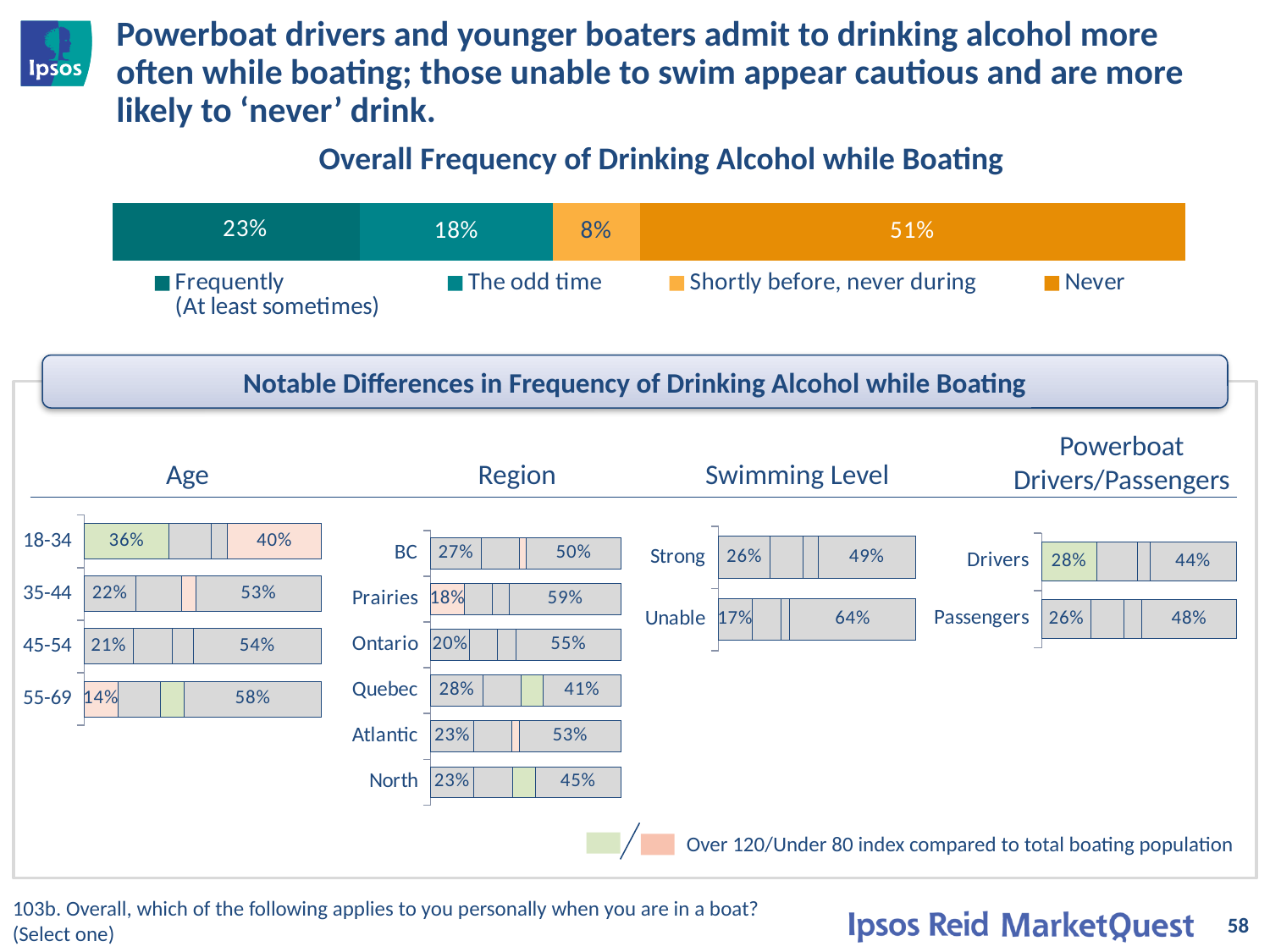
In the Swimming Level chart, what is the 'Never' percentage for those unable to swim? 64% In the 'Overall Frequency of Drinking Alcohol while Boating' chart, what percentage of boaters drink 'Frequently (At least sometimes)'? 23% In the Age chart, which age group has the highest 'Never' percentage? 55-69 What kind of chart is the 'Overall Frequency of Drinking Alcohol while Boating' chart? Stacked bar chart In the 'Overall Frequency of Drinking Alcohol while Boating' chart, what percentage of boaters answered 'Never'? 51% In the Region chart, which region has the highest 'Never' percentage? Prairies In the Age chart, what percentage of 18-34 year olds drink frequently while boating? 36% How many series does the legend of the 'Overall Frequency of Drinking Alcohol while Boating' chart list? 4 In the 'Overall Frequency of Drinking Alcohol while Boating' chart, what percentage answered 'Shortly before, never during'? 8% In the Region chart, what is the 'Never' percentage for Quebec? 41% In the Powerboat Drivers/Passengers chart, which group has the larger frequent-drinking percentage, Drivers or Passengers? Drivers In the 'Overall Frequency of Drinking Alcohol while Boating' chart, what is the difference between the 'Never' share and the 'Frequently (At least sometimes)' share? 28 percentage points